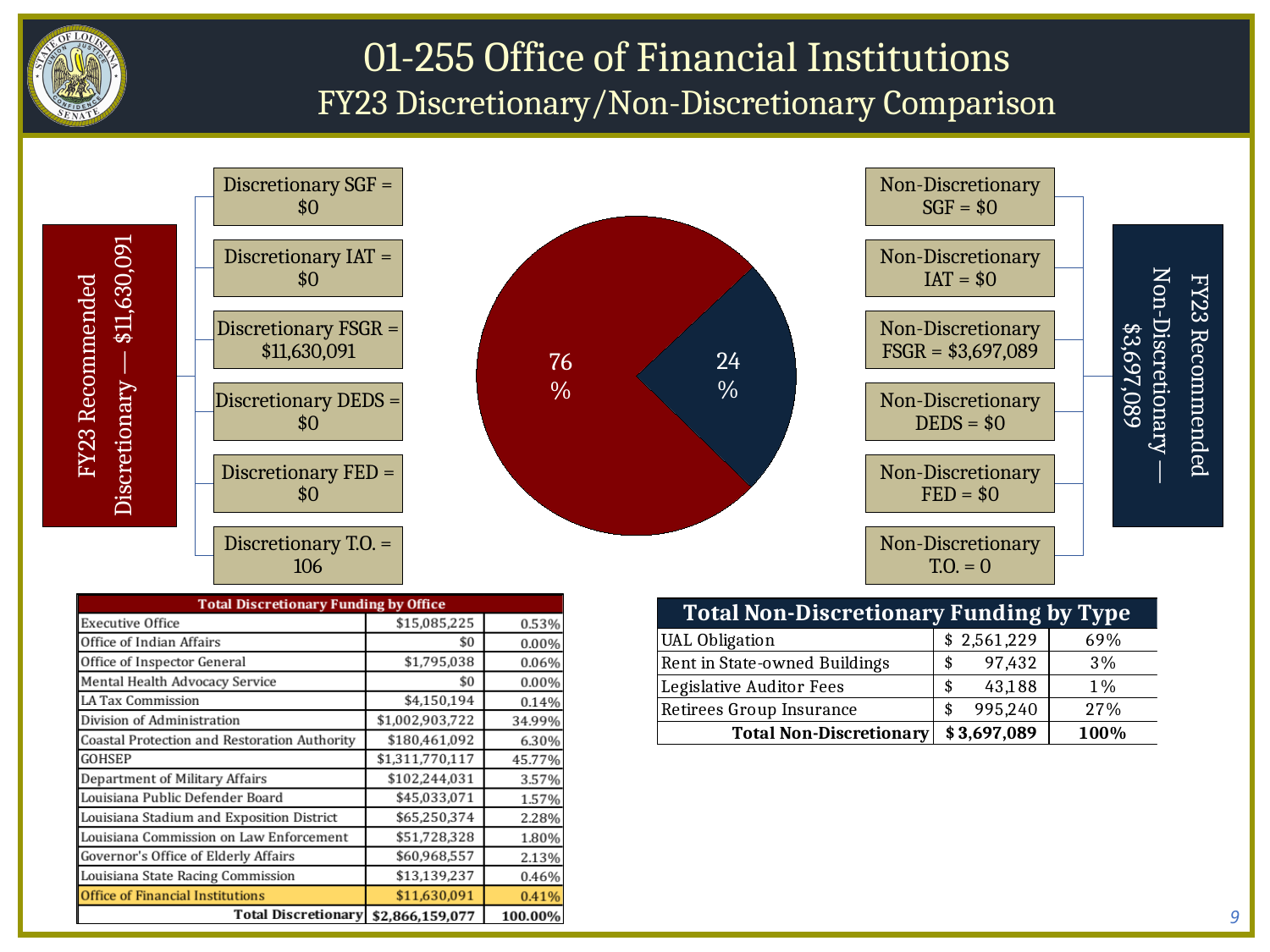
What colour is the larger slice of the pie chart? red What is the smallest share shown in the pie chart? 24% What share of the pie chart does the dark blue slice represent? 24% What share of the pie chart does the red slice represent? 76% Do the two slices of the pie chart add up to 100%? yes What is the difference in percentage points between the two slices of the pie chart? 52 How many slices does the pie chart have? 2 What kind of chart is shown in the centre of the slide? pie chart What is the largest share shown in the pie chart? 76% Which slice of the pie chart is larger, the red one or the dark blue one? the red one Is the share of the dark blue slice in the pie chart greater or less than 50%? less